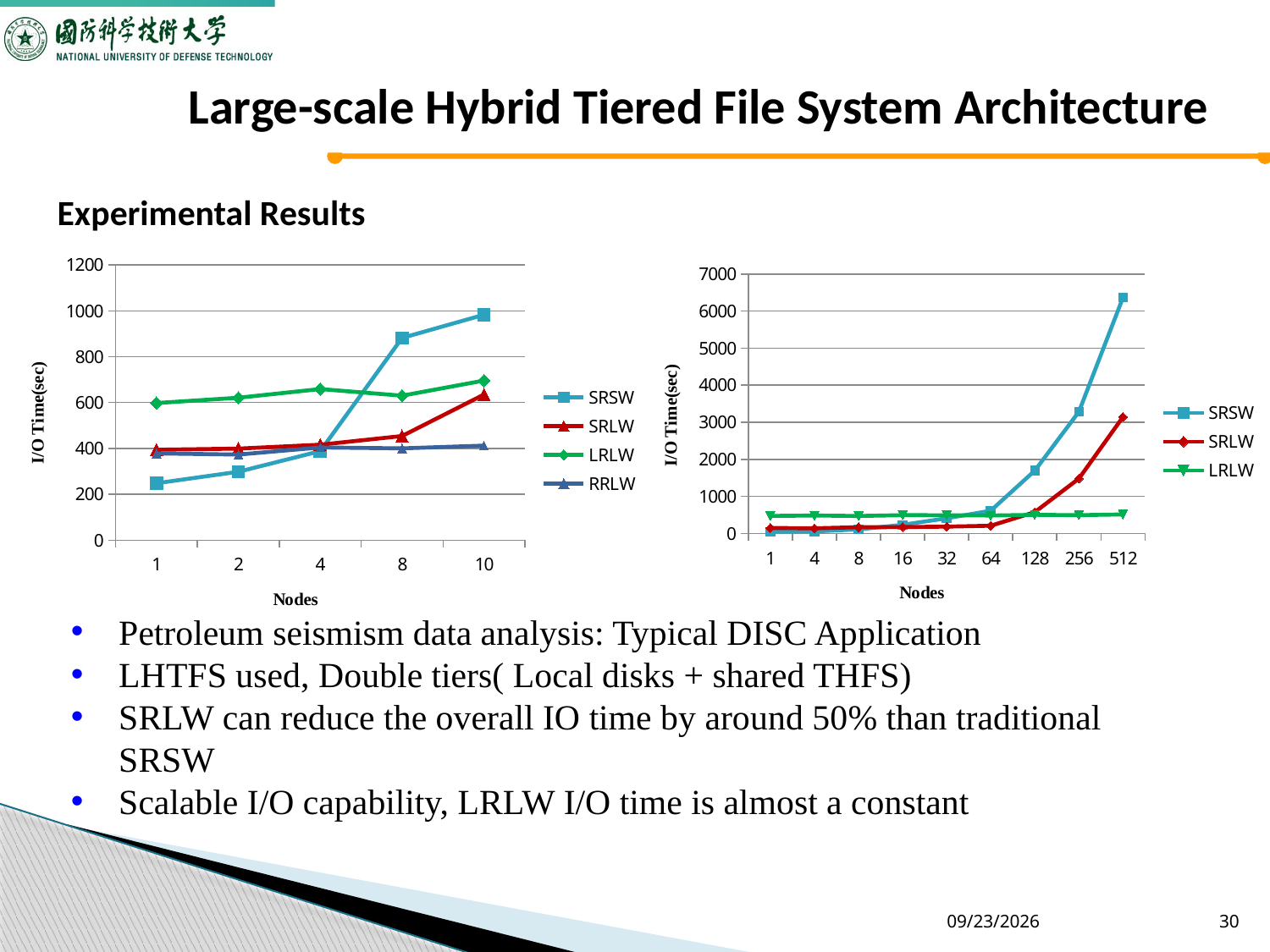
How many node counts are shown on the x axis of the right chart? 9 In the left chart, which series has the highest I/O time at 10 nodes? SRSW What kind of chart is the left chart on the slide? line chart In the left chart, which series has the lowest I/O time at 1 node? SRSW In the right chart, is the LRLW value at 512 nodes greater or less than 1000? less In the left chart, is the SRSW value at 1 node greater or less than 400? less How many series does the legend of the left chart list? 4 In the right chart, which series has the highest I/O time at 512 nodes? SRSW How many series does the legend of the right chart list? 3 In the right chart, is the SRSW value at 512 nodes greater or less than 6000? greater How many node counts are shown on the x axis of the left chart? 5